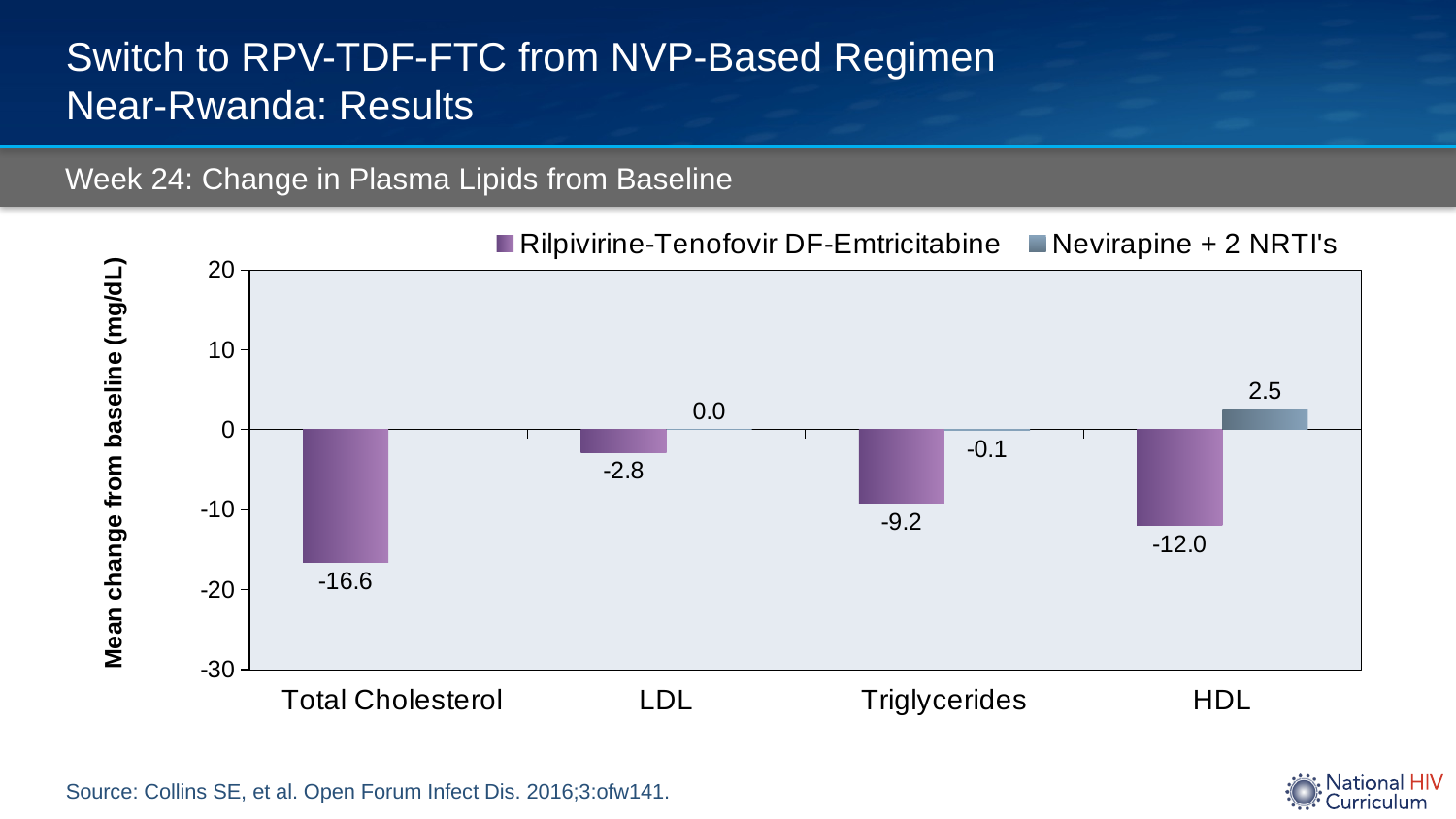
What is the mean change from baseline in Total Cholesterol for the Rilpivirine-Tenofovir DF-Emtricitabine group? -16.6 Which lipid category shows the lowest (most negative) value for the Rilpivirine-Tenofovir DF-Emtricitabine group? Total Cholesterol What is the mean change from baseline in HDL for the Nevirapine + 2 NRTI's group? 2.5 What is the mean change from baseline in HDL for the Rilpivirine-Tenofovir DF-Emtricitabine group? -12.0 For HDL, which group has the larger mean change from baseline? Nevirapine + 2 NRTI's How many lipid categories are shown on the x axis? 4 How many series does the legend list? 2 What is the difference between the Rilpivirine-Tenofovir DF-Emtricitabine values for Total Cholesterol and LDL? 13.8 Which lipid category shows the highest value for the Rilpivirine-Tenofovir DF-Emtricitabine group? LDL What kind of chart is shown on the slide? Bar chart What is the mean change from baseline in LDL for the Nevirapine + 2 NRTI's group? 0.0 What is the mean change from baseline in Triglycerides for the Nevirapine + 2 NRTI's group? -0.1